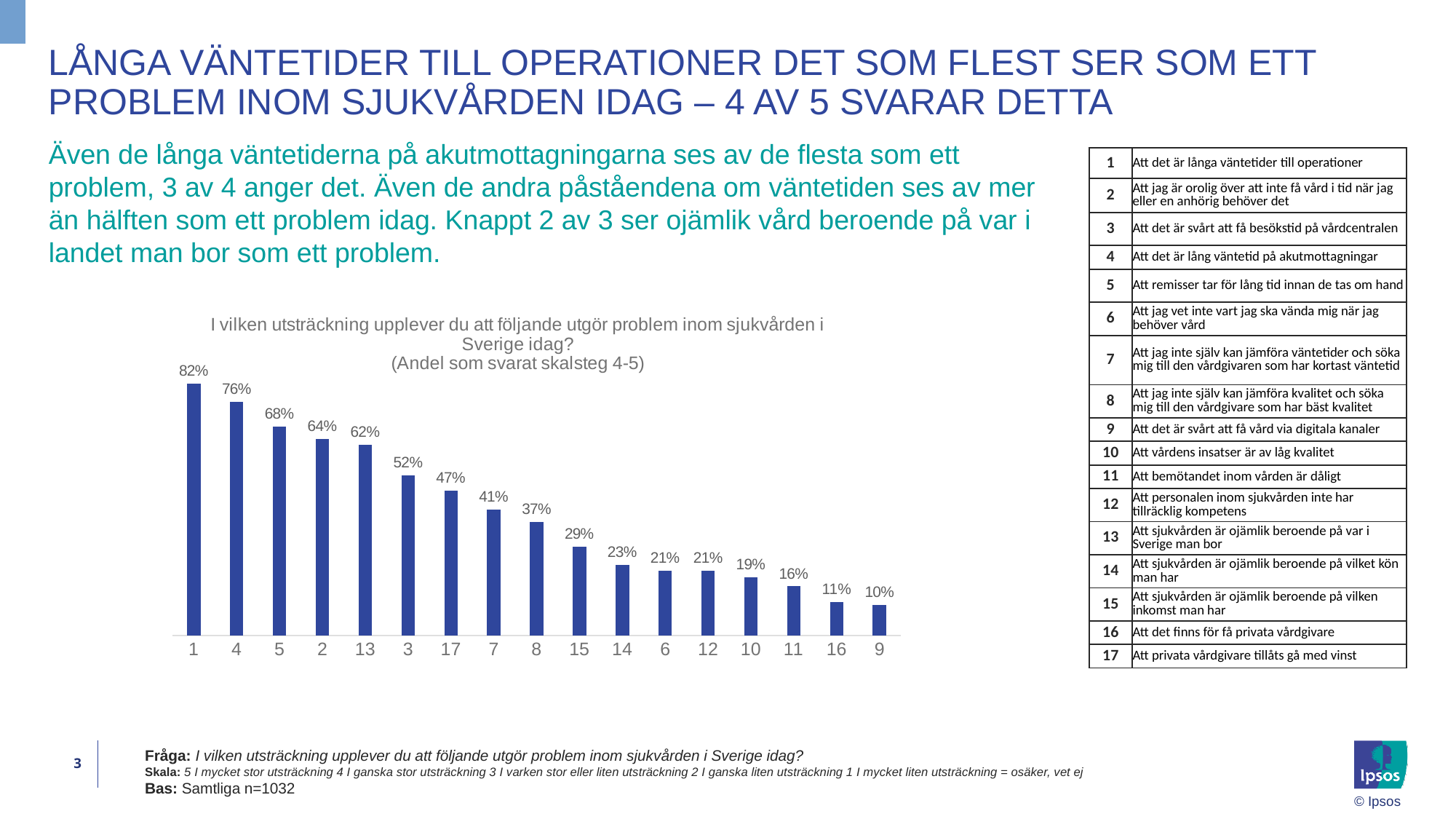
Which category has the highest value in the bar chart? 1 How many bars are shown in the chart? 17 Which has a larger value, category 7 or category 8? 7 What is the value for category 13 in the bar chart? 62% What type of chart is shown on the slide? bar chart What is the difference between the values for category 3 and category 17? 5% What is the difference between the values for category 1 and category 4? 6% What is the value for category 9 in the bar chart? 10% Which category has the lowest value in the bar chart? 9 What is the value for category 15 in the bar chart? 29% Do the values rise or fall from left to right along the x axis? fall What is the value for category 1 in the bar chart? 82%